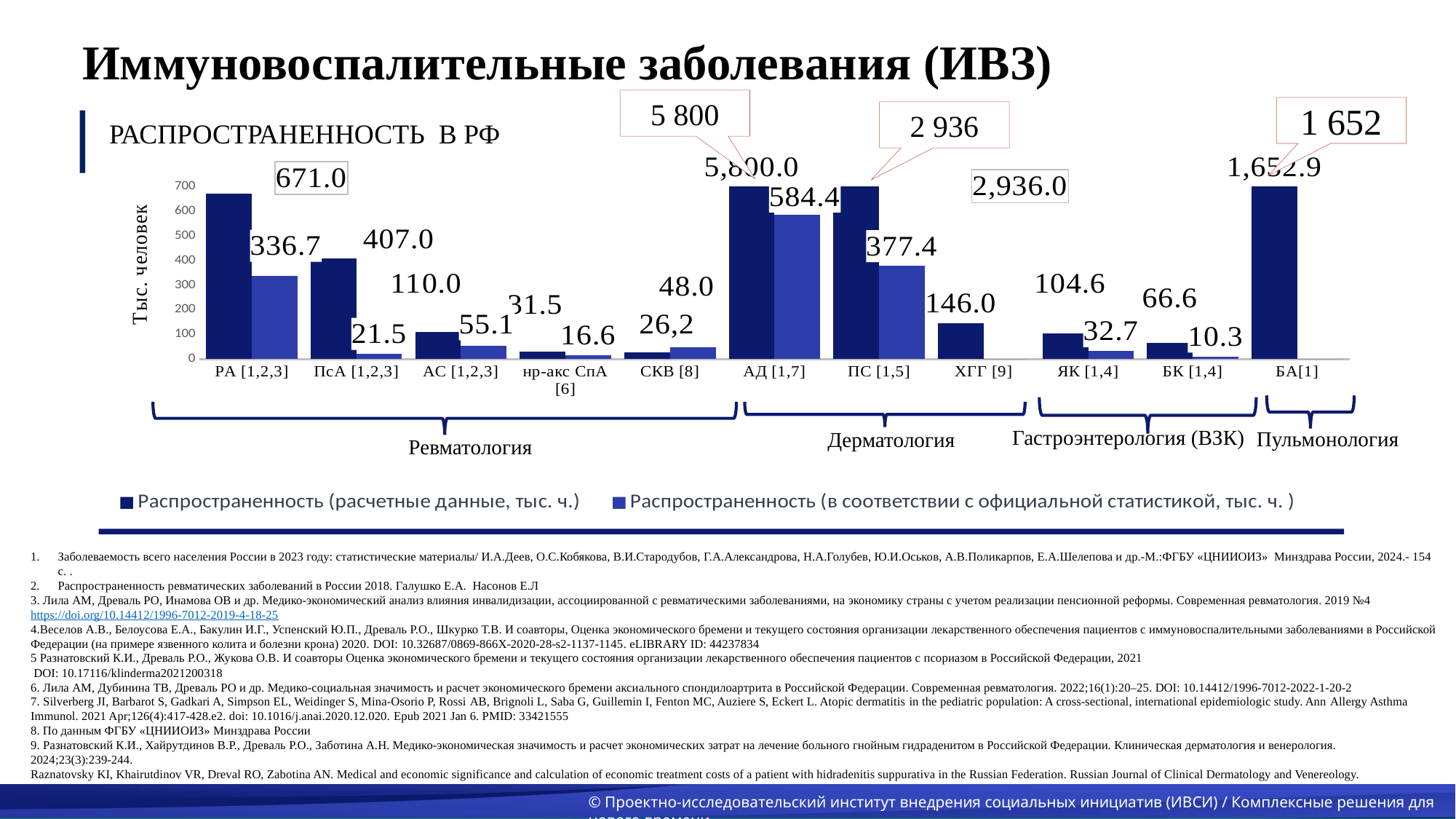
What is the difference between the calculated prevalence and the official-statistics prevalence for РА [1,2,3]? 334.3 What is the prevalence according to official statistics for ПС [1,5]? 377.4 What is the prevalence according to official statistics for ПсА [1,2,3]? 21.5 How many disease categories are shown on the x axis? 11 Which category has the highest calculated prevalence (расчетные данные)? АД [1,7] What is the calculated prevalence for АД [1,7]? 5,800.0 How many series does the legend list? 2 What is the y-axis label of the chart? Тыс. человек Which is larger for СКВ [8]: the calculated prevalence or the prevalence according to official statistics? official statistics (48.0) What is the calculated prevalence (расчетные данные) for РА [1,2,3]? 671.0 What type of chart is shown on the slide? bar chart